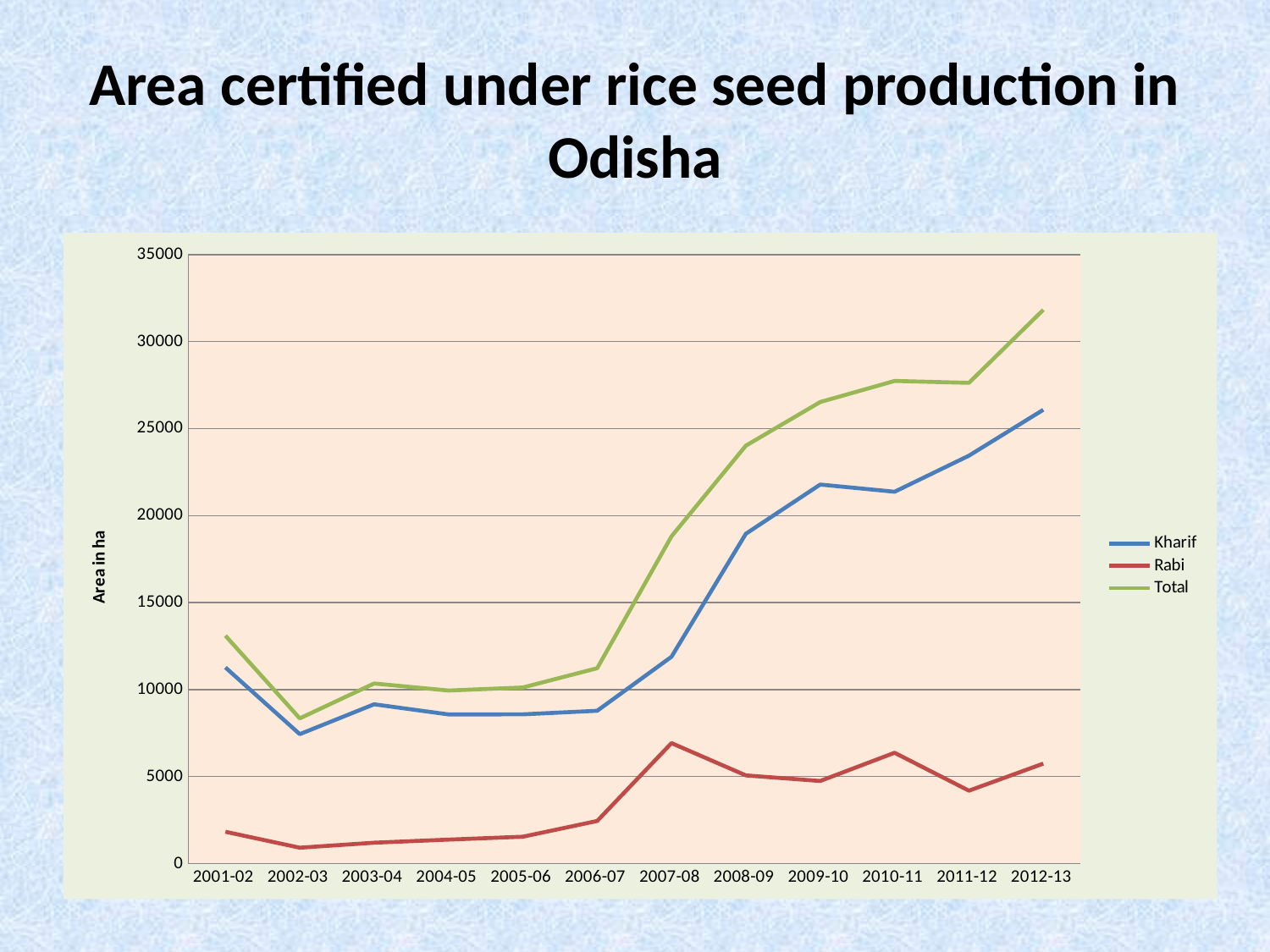
What kind of chart is shown on the slide? line chart Which series has the larger value in 2012-13, Kharif or Rabi? Kharif How many series does the legend list? 3 How many years are plotted along the x axis? 12 Is the Kharif value for 2002-03 greater or less than 10000? less In which year is the Total series at its lowest? 2002-03 What is the label on the y axis? Area in ha In which year does the Rabi series reach its highest value? 2007-08 Is the Total value for 2012-13 greater or less than 30000? greater In which year is the Kharif series at its lowest? 2002-03 In which year is the Total series at its highest? 2012-13 Is the Rabi value for 2007-08 greater or less than 5000? greater